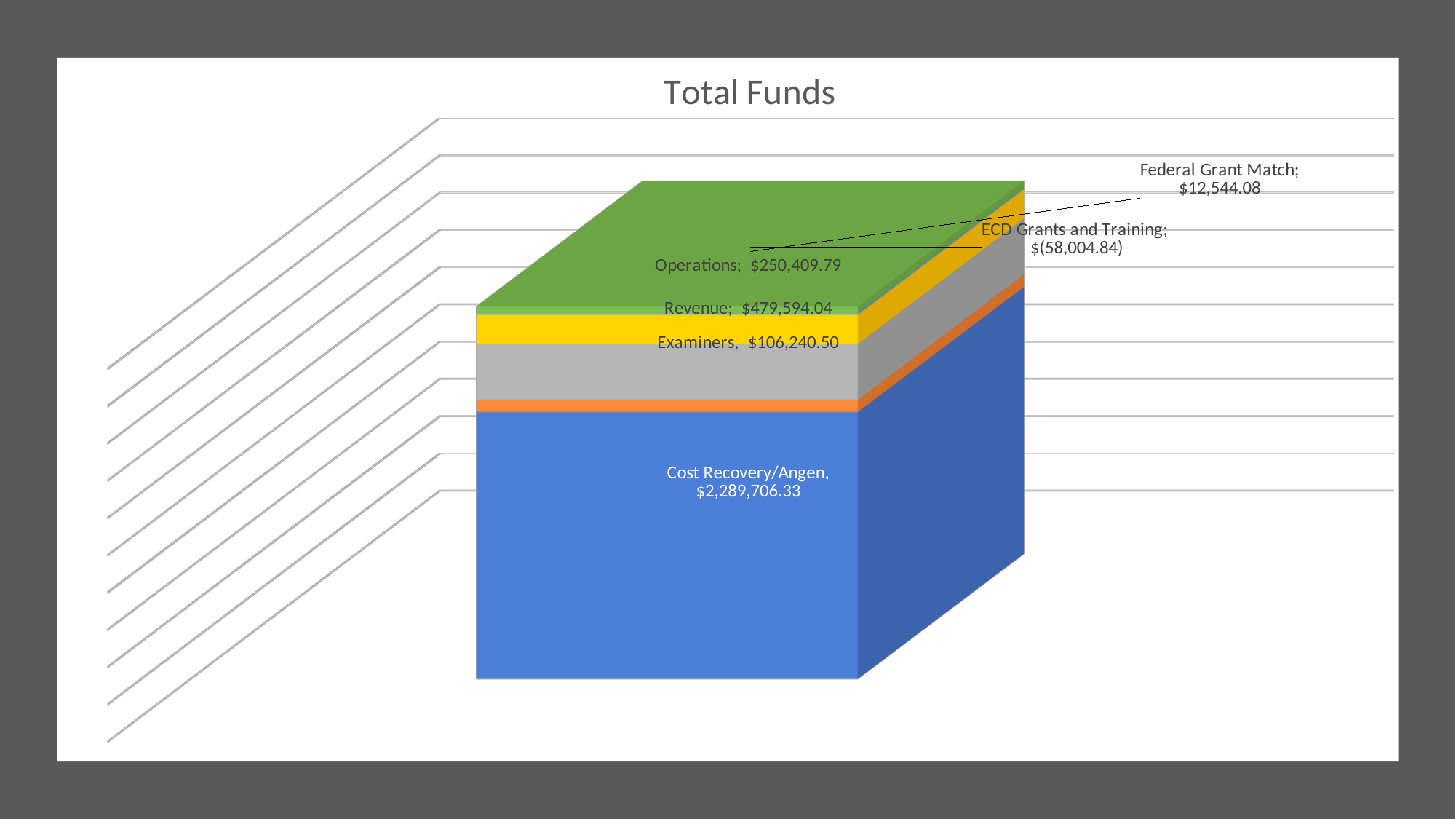
What is the value labelled for Federal Grant Match? $12,544.08 What is the value labelled for Examiners? $106,240.50 What is the title of the chart? Total Funds What is the value labelled for Operations? $250,409.79 Which category has the smallest value? ECD Grants and Training What is the value labelled for ECD Grants and Training? $(58,004.84) Which category has the largest value? Cost Recovery/Angen What is the difference between the Revenue value and the Operations value? $229,184.25 What kind of chart is shown on the slide? Stacked bar chart Which is larger, Revenue or Operations? Revenue What is the value labelled for Revenue? $479,594.04 What is the value labelled for Cost Recovery/Angen? $2,289,706.33